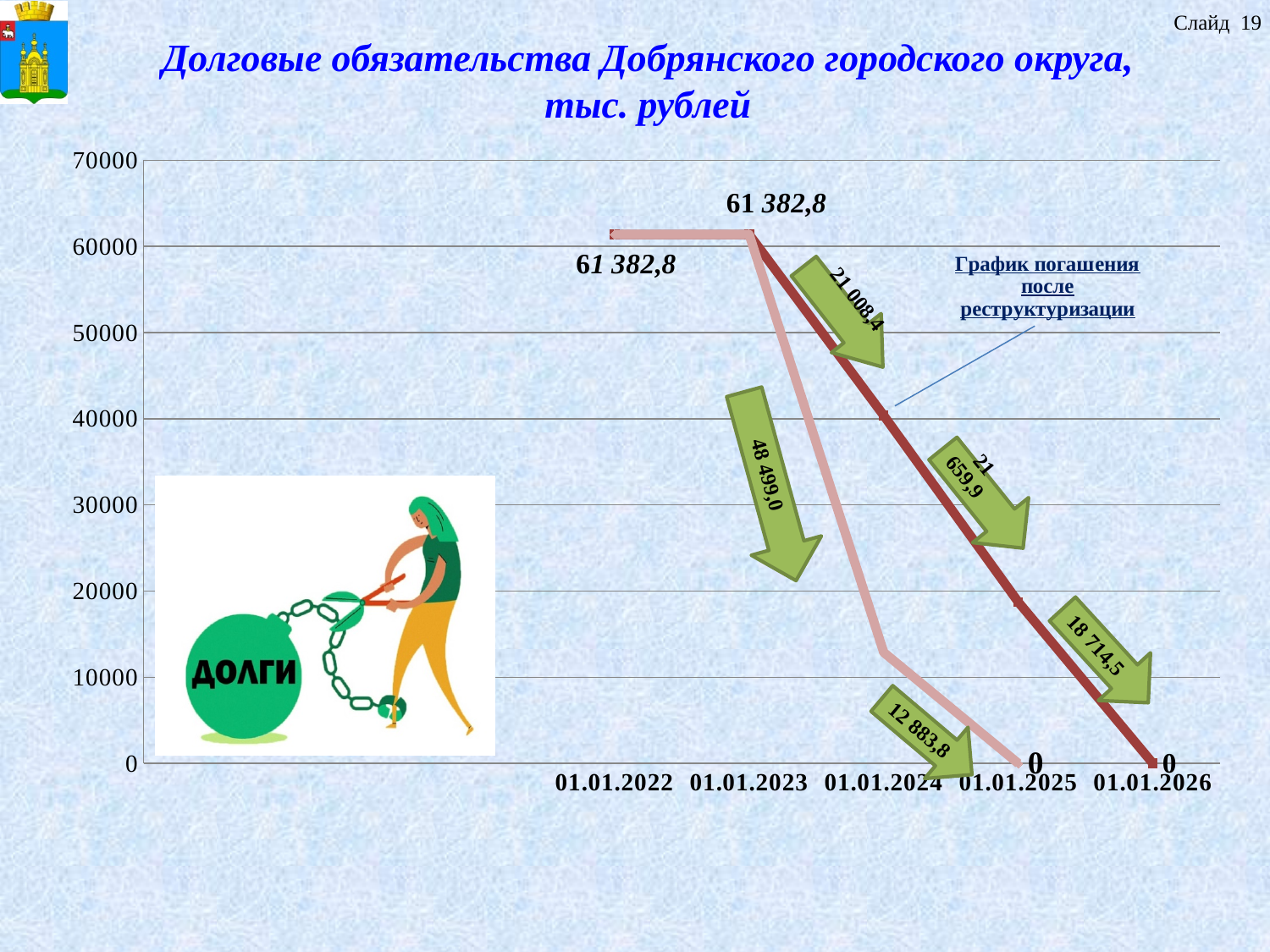
Do the debt values rise or fall along the x axis after 01.01.2023? fall What is the value of debt obligations at 01.01.2022? 61 382,8 Which line does the annotation 'График погашения после реструктуризации' point to? the dark red line What is the value of the original repayment schedule (pink line) at 01.01.2025? 0 Is the value of the dark red line at 01.01.2024 greater or less than 30000? greater What is the value of the restructured repayment schedule (dark red line) at 01.01.2026? 0 What is the title of the chart? Долговые обязательства Добрянского городского округа, тыс. рублей Is the value of the pink line at 01.01.2024 greater or less than 20000? less What is the value of debt obligations at 01.01.2023? 61 382,8 At 01.01.2024, which line is higher: the pink line or the dark red line? the dark red line How many dates are shown on the x axis? 5 What kind of chart is shown on the slide? line chart